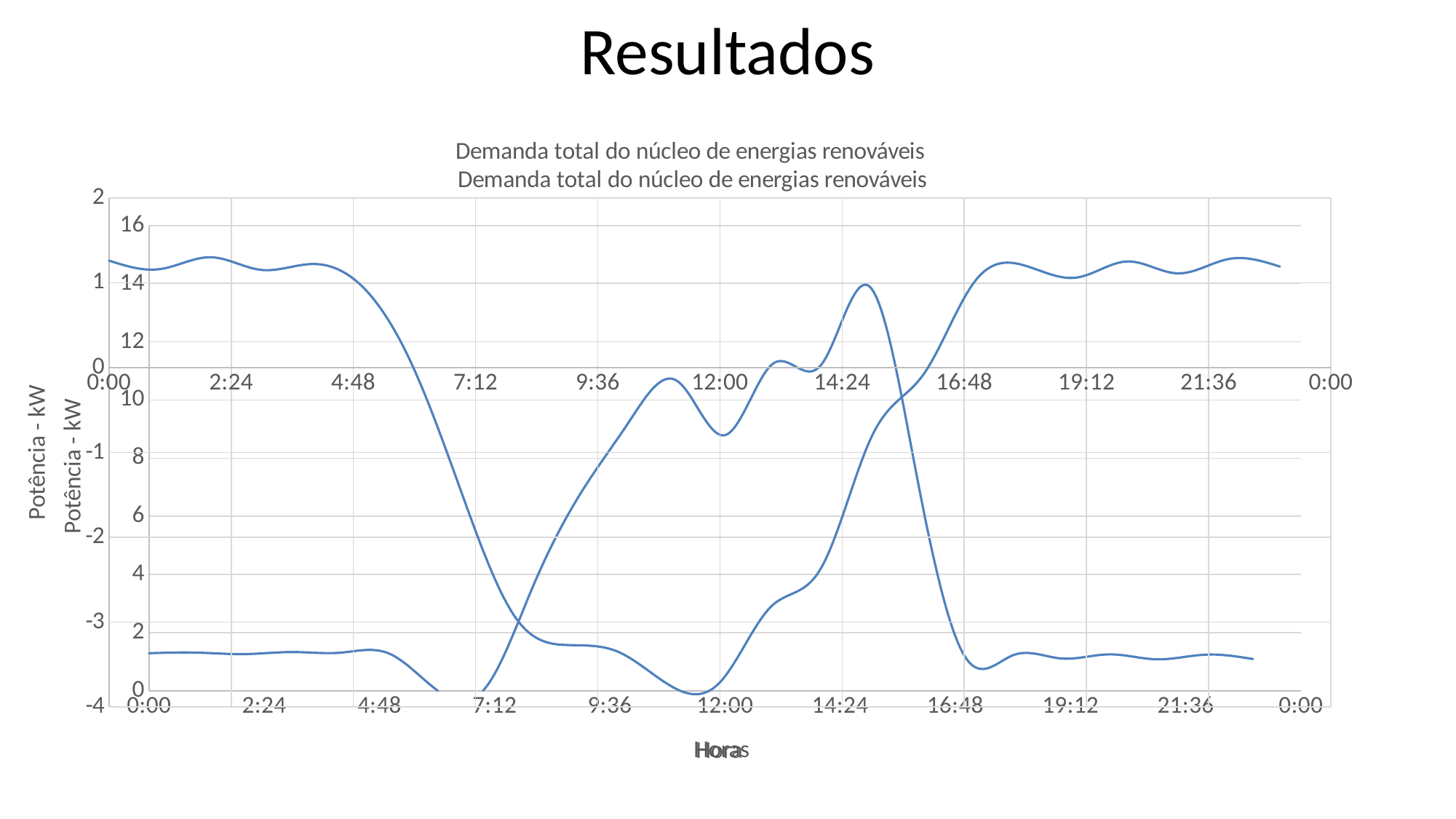
What is the title of the chart? Demanda total do núcleo de energias renováveis What is the label of the x axis of the chart? Horas What kind of chart is shown on the slide? line chart On the y axis running from 0 to 16, is the value of the upper line at 7:12 greater or less than 8? less Does the upper line rise or fall between 4:48 and 7:12? fall